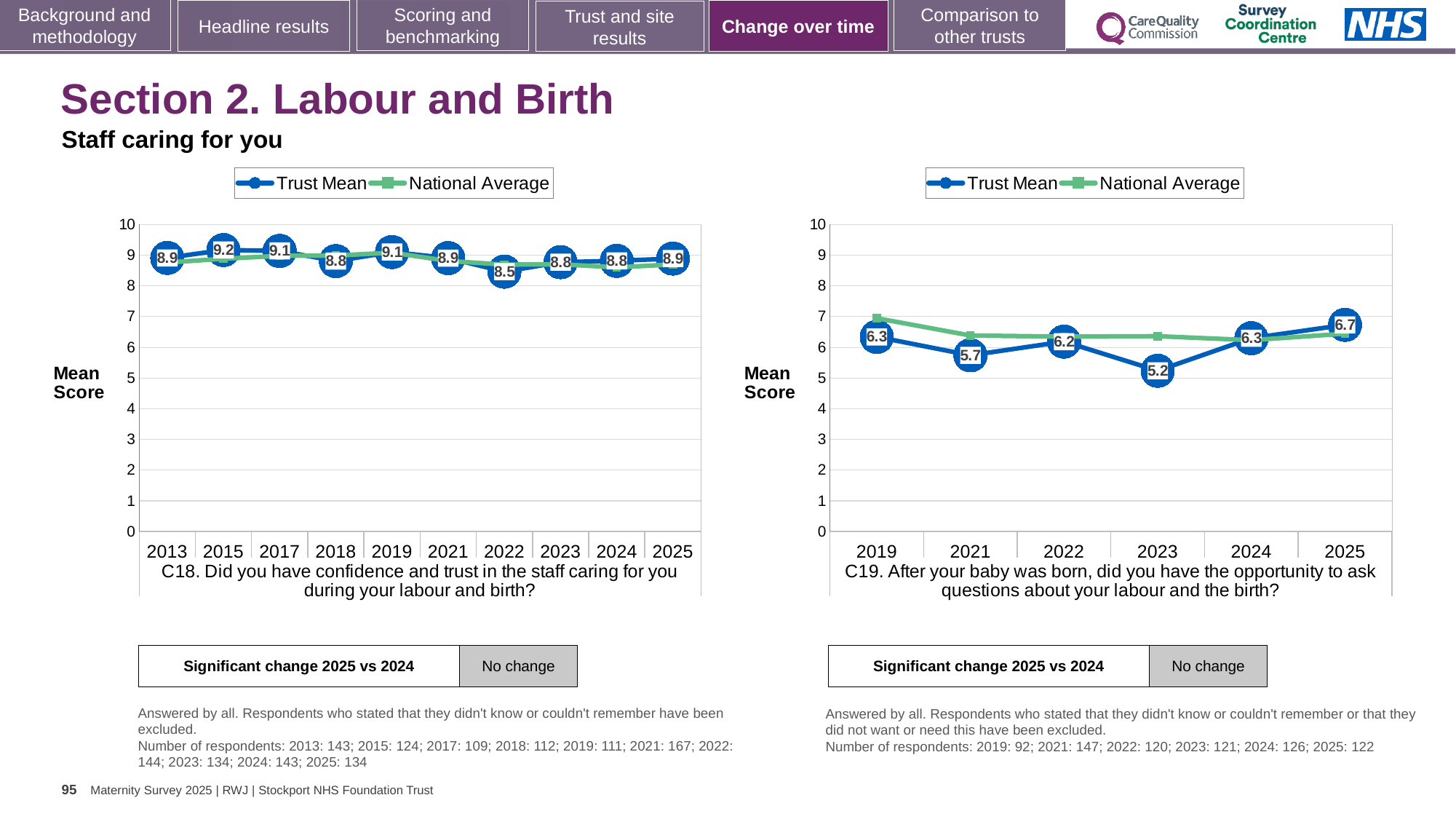
In the C18 chart, what is the Trust Mean for 2015? 9.2 How many series does the legend of the C19 chart list? 2 In the C18 chart, what is the Trust Mean for 2022? 8.5 In the C19 chart, what is the Trust Mean for 2025? 6.7 In the C18 chart, which year has the lowest Trust Mean? 2022 In the C19 chart, what is the Trust Mean for 2023? 5.2 In the C18 chart, how many years are plotted on the x axis? 10 In the C19 chart, is the National Average for 2019 greater or less than 6? greater In the C19 chart, what is the difference between the Trust Mean in 2025 and in 2023? 1.5 In the C19 chart, which is larger, the Trust Mean for 2021 or for 2022? 2022 In the C18 chart, what is the difference between the Trust Mean in 2015 and in 2022? 0.7 In the C19 chart, which year has the highest Trust Mean? 2025